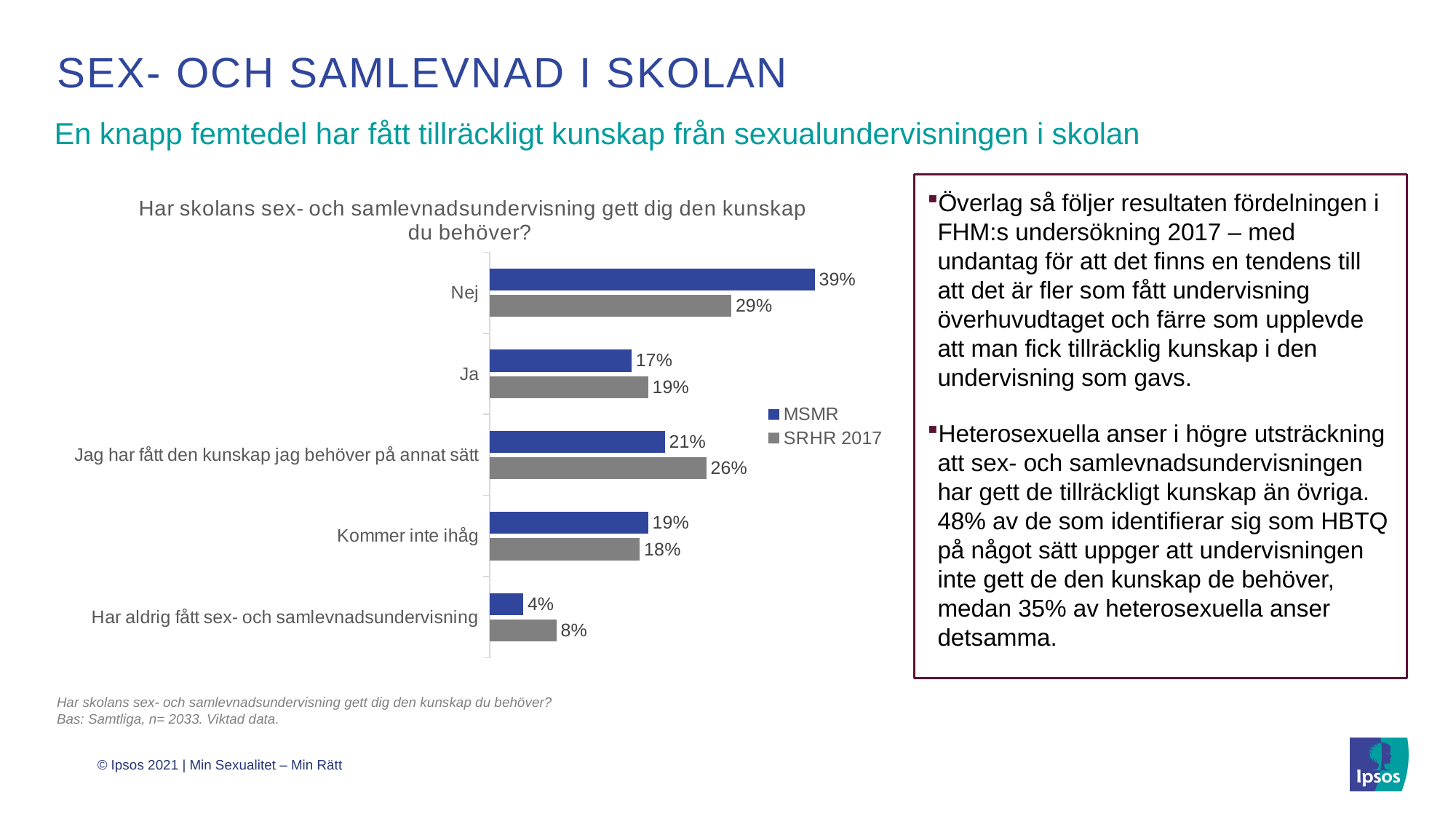
What is the difference between the MSMR and SRHR 2017 values for "Nej"? 10 percentage points What is the MSMR value for "Har aldrig fått sex- och samlevnadsundervisning"? 4% Which category has the lowest SRHR 2017 value? Har aldrig fått sex- och samlevnadsundervisning What is the SRHR 2017 value for "Ja"? 19% What kind of chart is shown on the slide? Bar chart How many series does the legend list? 2 What is the MSMR value for "Nej"? 39% What is the SRHR 2017 value for "Jag har fått den kunskap jag behöver på annat sätt"? 26% For "Kommer inte ihåg", which series has the larger value, MSMR or SRHR 2017? MSMR What is the title of the chart? Har skolans sex- och samlevnadsundervisning gett dig den kunskap du behöver? Which category has the highest MSMR value? Nej How many categories are shown in the chart? 5